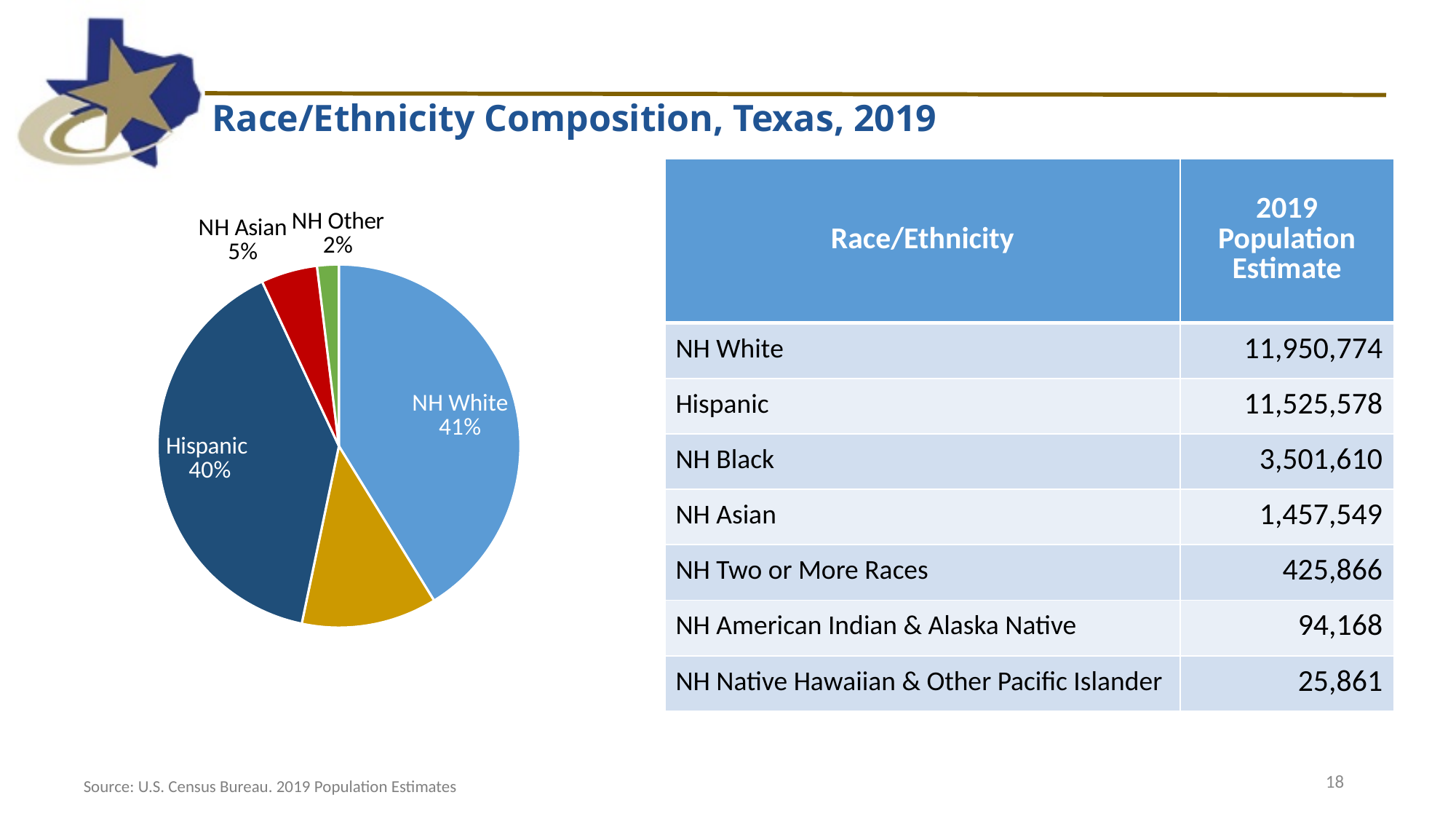
What share of the pie does NH Other represent? 2% What colour is the Hispanic slice of the pie chart? dark blue Which labeled slice of the pie chart has the smallest share? NH Other By how many percentage points does the NH Asian share exceed the NH Other share? 3 percentage points By how many percentage points does the NH White share exceed the Hispanic share? 1 percentage point How many slices does the pie chart have? 5 What share of the pie does NH White represent? 41% What kind of chart is shown on the slide? pie chart What share of the pie does Hispanic represent? 40% Which labeled slice of the pie chart has the largest share? NH White Which has the larger share of the pie, NH Asian or NH Other? NH Asian